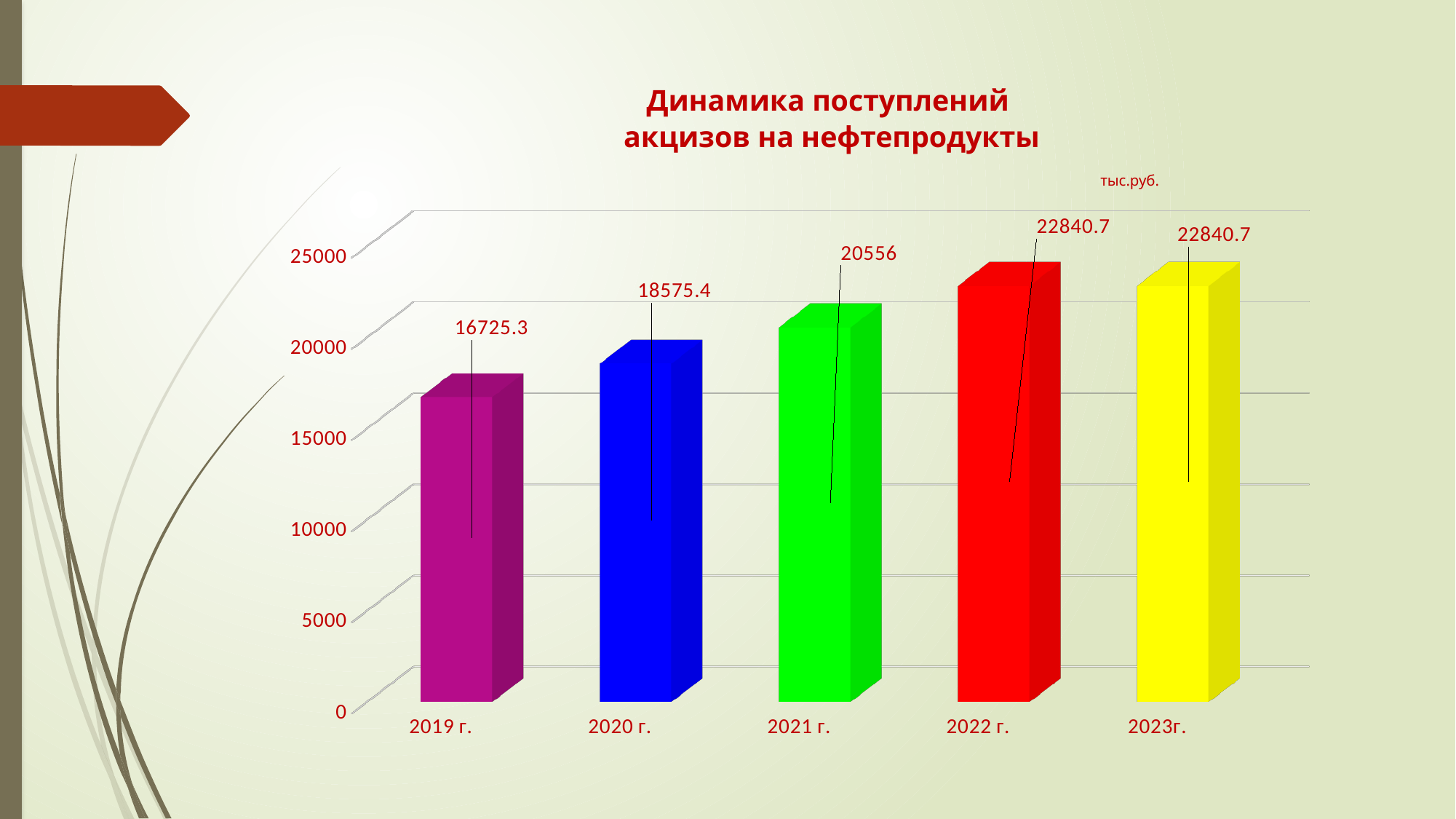
Which is larger, the value for 2021 г. or the value for 2020 г.? 2021 г. What is the value for 2019 г.? 16725.3 Is the value for 2019 г. greater or less than 20000? less How many years are shown on the x axis? 5 What unit is indicated for the values on the chart? тыс.руб. What is the value for 2022 г.? 22840.7 What is the difference between the values for 2020 г. and 2019 г.? 1850.1 What is the value for 2021 г.? 20556 What kind of chart is shown on the slide? bar chart What is the difference between the values for 2022 г. and 2021 г.? 2284.7 Which year has the lowest value? 2019 г. What is the value for 2020 г.? 18575.4